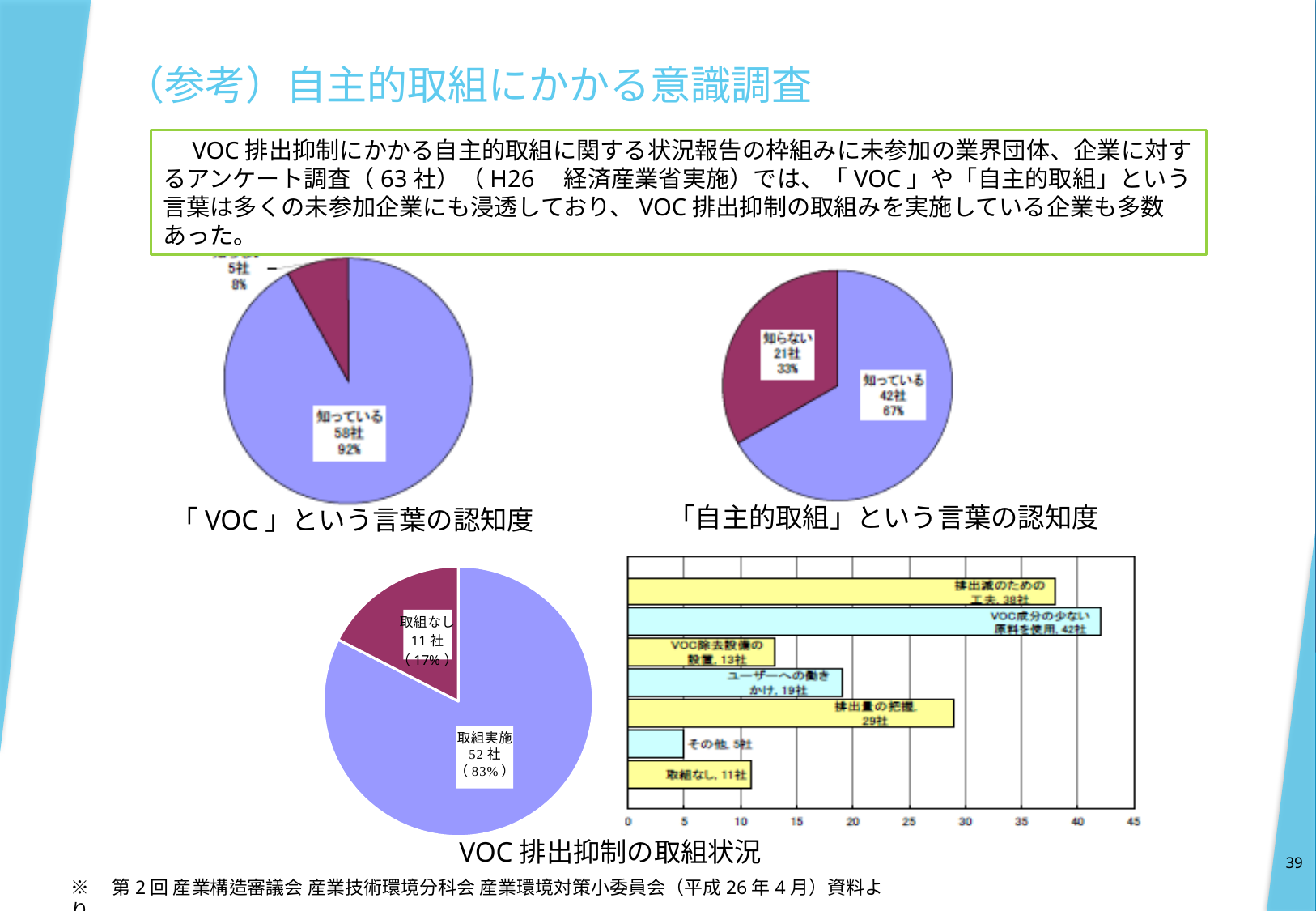
In the pie chart titled 「VOC」という言葉の認知度, how many companies answered 知っている? 58社 In the pie chart titled 「自主的取組」という言葉の認知度, which slice is larger, 知っている or 知らない? 知っている In the bar chart at the bottom right, which category has the highest value? VOC成分の少ない原料を使用 In the pie chart titled 「自主的取組」という言葉の認知度, how many companies answered 知らない? 21社 In the pie chart titled 「VOC」という言葉の認知度, what percentage share does 知っている have? 92% In the bar chart at the bottom right, which category has the lowest value? その他 In the pie chart titled VOC排出抑制の取組状況 (bottom left), how many companies are in the 取組実施 slice? 52社 In the pie chart titled 「自主的取組」という言葉の認知度, what percentage share does 知っている have? 67% In the bar chart at the bottom right, what is the difference between 排出減のための工夫 and VOC除去設備の設置? 25社 In the pie chart titled VOC排出抑制の取組状況 (bottom left), what percentage share does 取組なし have? 17% In the bar chart at the bottom right, what is the value for 排出量の把握? 29社 What kind of chart is shown at the bottom right of the slide? Bar chart